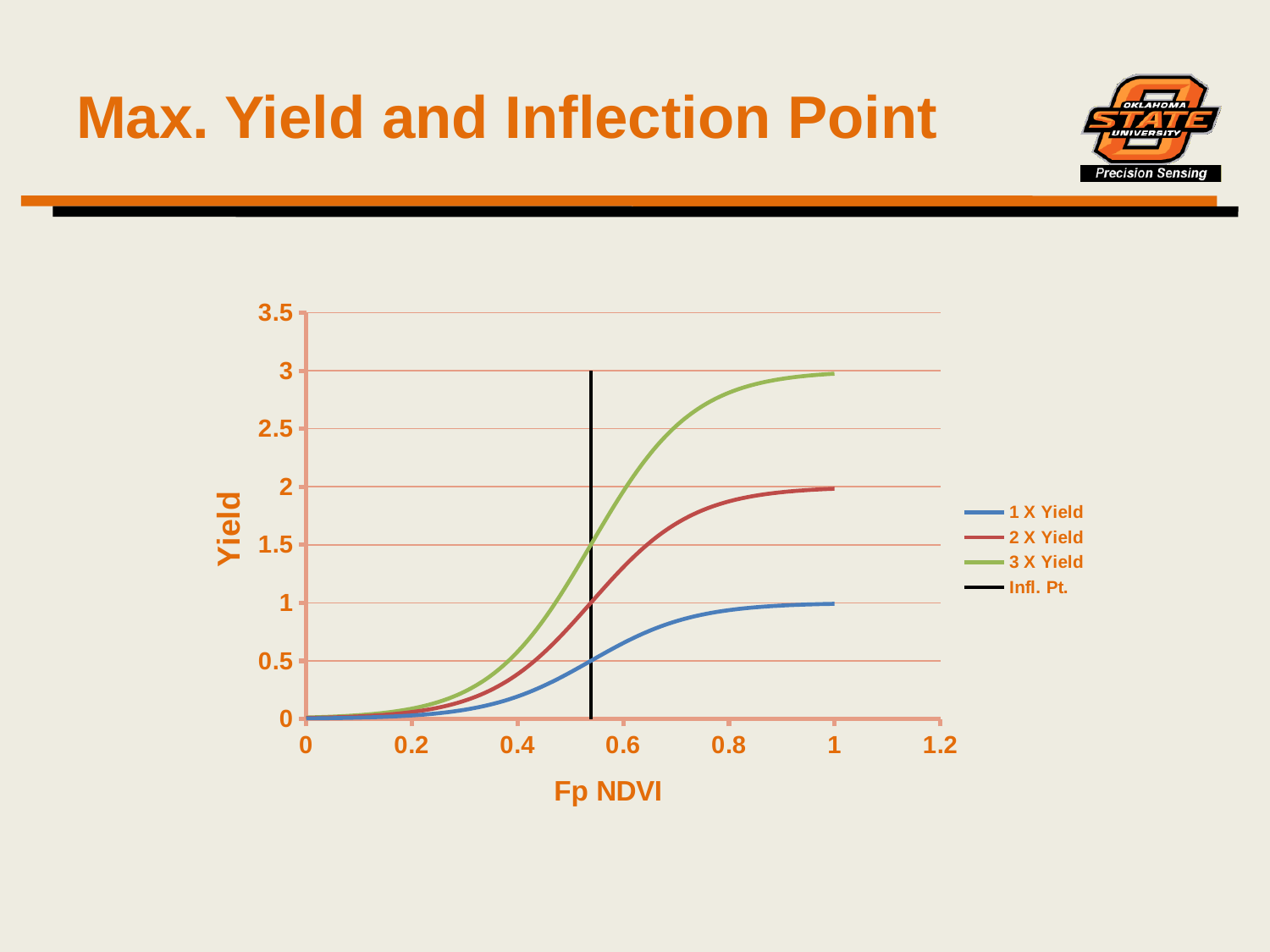
Is the value of the 2 X Yield curve at Fp NDVI = 0.8 greater or less than 1.5? greater Which yield series reaches the highest value at Fp NDVI = 1? 3 X Yield At Fp NDVI = 0.6, which is larger: the 2 X Yield curve or the 1 X Yield curve? 2 X Yield Which yield series has the lowest value at Fp NDVI = 1? 1 X Yield Is the value of the 3 X Yield curve at Fp NDVI = 0.4 greater or less than 1? less What is the title of the x axis of the chart? Fp NDVI Is the value of the 1 X Yield curve at Fp NDVI = 0.6 greater or less than 1? less Do the yield curves rise or fall as Fp NDVI increases from 0 to 1? rise What kind of chart is shown on the slide? line chart How many entries does the chart legend list? 4